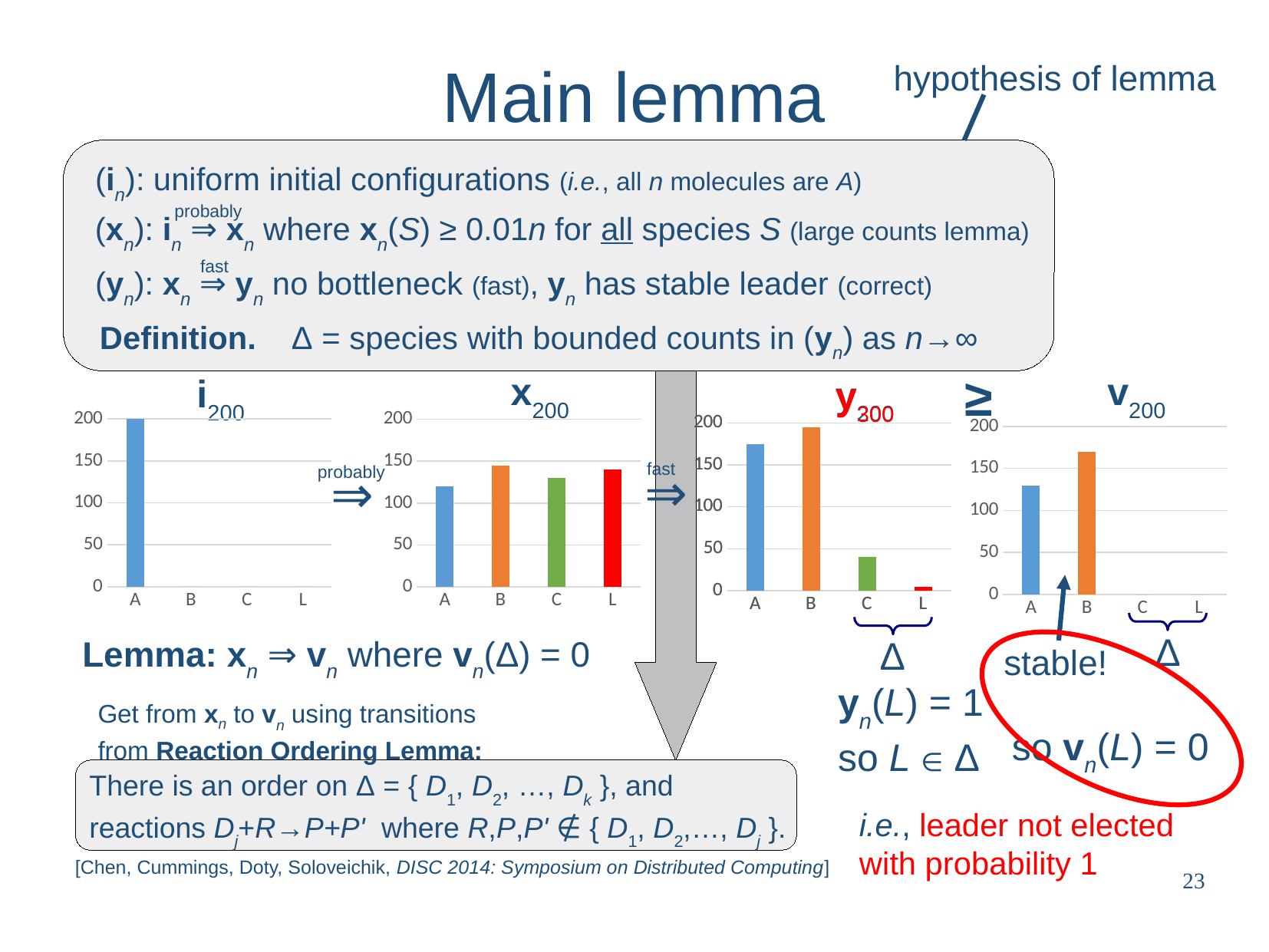
In the v_200 chart, is the value for A greater or less than 100? greater In the y_200 chart, which category has the lowest value? L In the x_200 chart, is the value for A greater or less than 150? less In the x_200 chart, is the value for B greater or less than 100? greater How many categories are shown on the x axis of the x_200 chart? 4 What kind of chart is the y_200 chart? bar chart In the v_200 chart, which is larger, the value for A or the value for B? B In the i_200 chart, what is the value for category A? 200 How many bar charts are shown on the slide? 4 In the y_200 chart, which category has the highest value? B In the i_200 chart, which category has the highest value? A